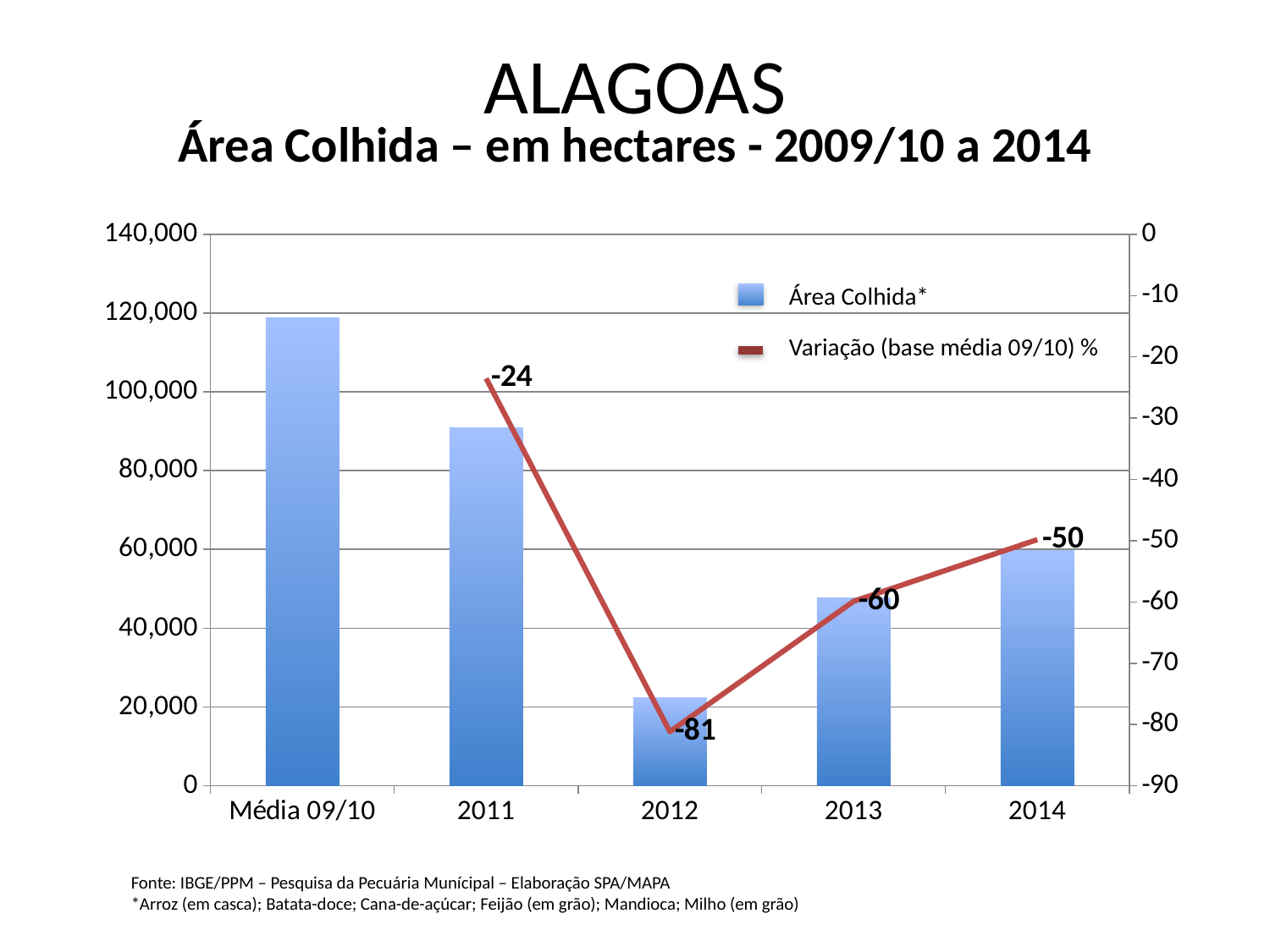
Is the Área Colhida bar for 2014 larger or smaller than the bar for 2013? larger Is the Área Colhida value for 2013 greater or less than 60,000? less Which year has the lowest Variação (base média 09/10) % value? 2012 How many series does the legend list? 2 What is the Variação (base média 09/10) % value for 2011? -24 How many categories are shown on the x axis? 5 What is the Variação (base média 09/10) % value for 2014? -50 What is the difference between the Variação values for 2013 and 2012? 21 Which category has the lowest Área Colhida bar? 2012 Is the Área Colhida value for 2011 greater or less than 80,000? greater What is the Variação (base média 09/10) % value for 2012? -81 Which category has the highest Área Colhida bar? Média 09/10